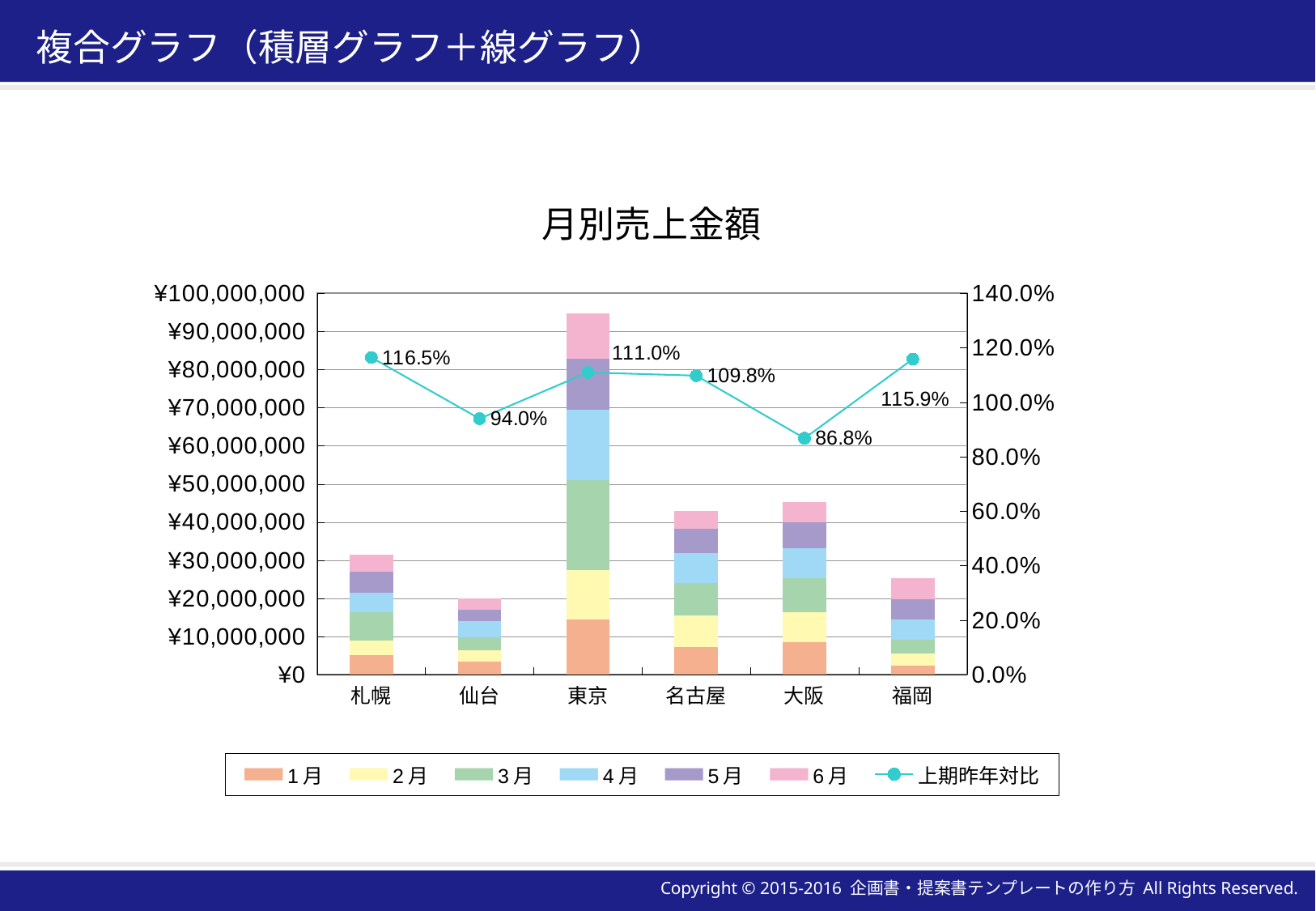
Which city has the tallest stacked bar (highest total sales)? 東京 How many cities are shown on the x axis? 6 Is the total stacked bar value for 福岡 greater or less than ¥30,000,000? less How many series does the legend list? 7 Which city has the lowest 上期昨年対比 value? 大阪 Which city has the highest 上期昨年対比 value? 札幌 Which has a higher 上期昨年対比 value, 東京 or 名古屋? 東京 What is the difference between the 上期昨年対比 values for 札幌 and 大阪? 29.7 percentage points What is the 上期昨年対比 value for 仙台? 94.0% What is the 上期昨年対比 value for 大阪? 86.8% What is the 上期昨年対比 value for 札幌? 116.5% Is the total stacked bar value for 東京 greater or less than ¥90,000,000? greater